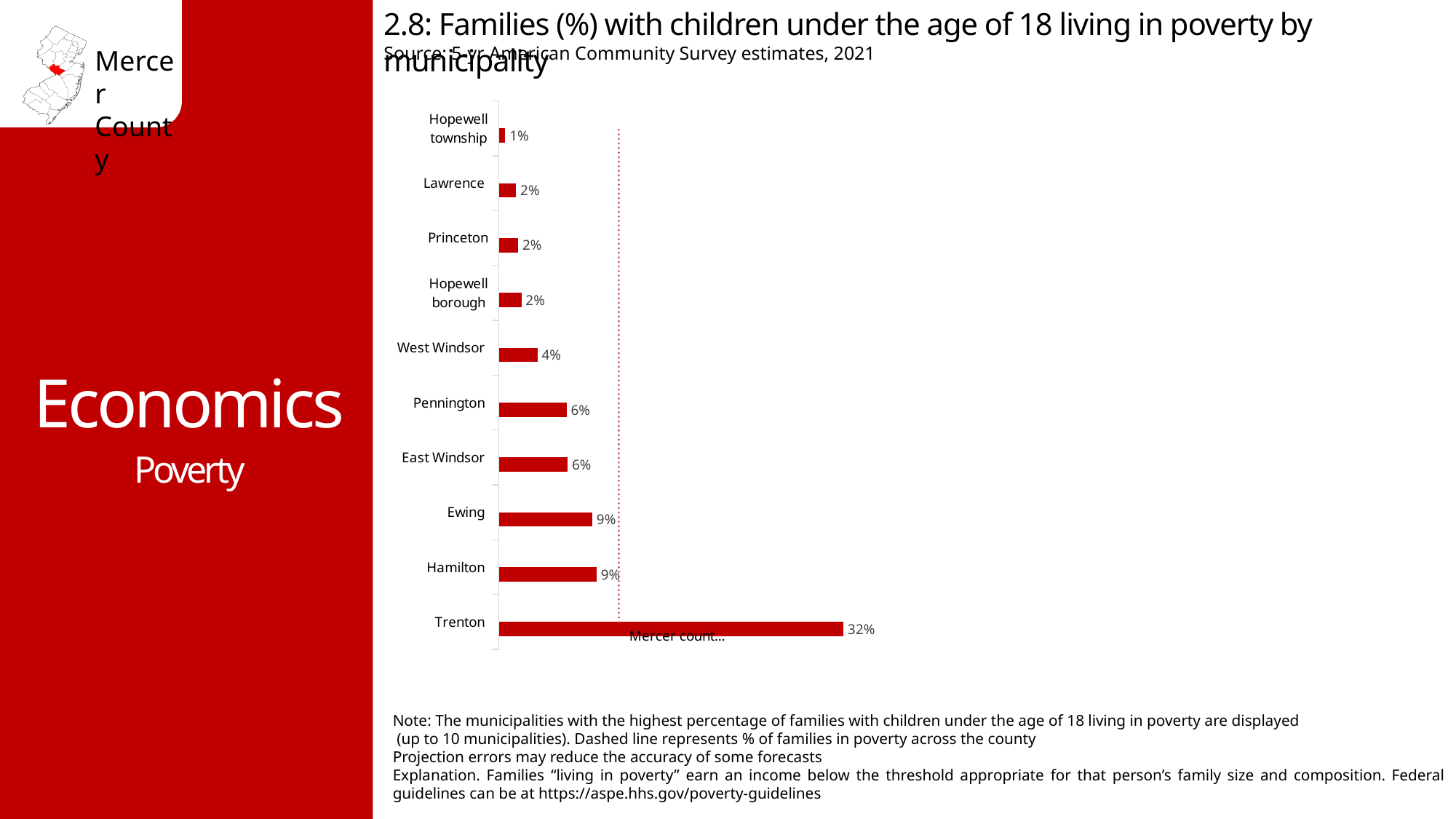
What is the value shown for Ewing? 9% What is the value shown for West Windsor? 4% What is the difference between the values for Trenton and Hamilton? 23% Which municipality has the lowest percentage of families with children under 18 living in poverty? Hopewell township What is the value shown for Hopewell township? 1% What percentage of families with children under 18 live in poverty in Trenton? 32% Which municipality has the highest percentage of families with children under 18 living in poverty? Trenton What does the dashed vertical line in the chart represent? % of families in poverty across the county What is the difference between the values for Pennington and Lawrence? 4% What type of chart is used on this slide? Bar chart Which has a higher value, Ewing or West Windsor? Ewing How many municipalities are shown in the chart? 10